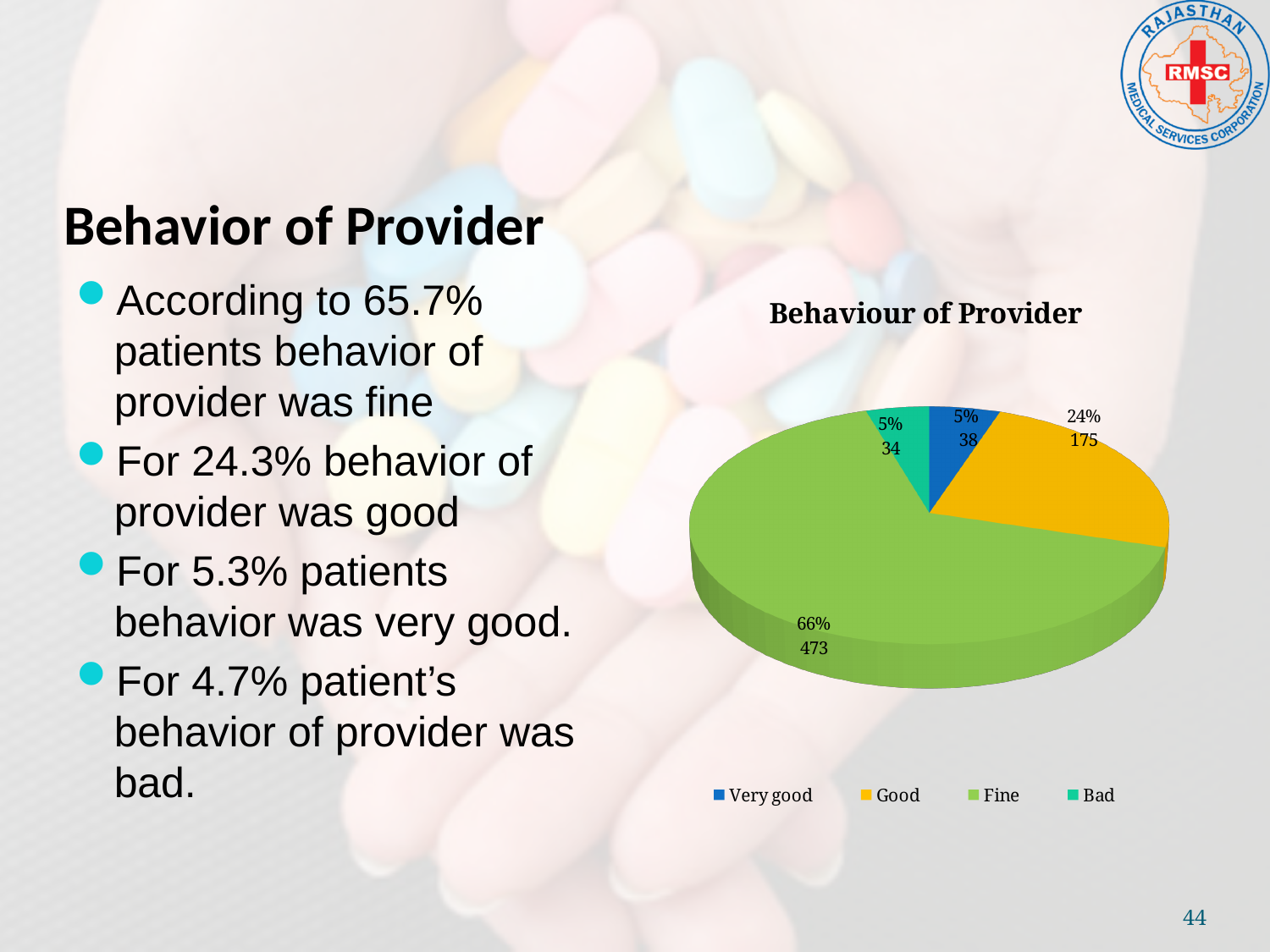
What type of chart is shown on the slide? pie chart What count is shown for the Very good slice? 38 How many categories does the legend of the pie chart list? 4 What count is shown for the Bad slice? 34 Which has a larger count, Very good or Bad? Very good What share of the pie does the Fine slice represent? 66% What is the title of the chart? Behaviour of Provider Which category has the smallest count in the pie chart? Bad What is the difference between the counts for Fine and Good? 298 Which category has the largest slice of the pie? Fine What percentage is shown for the Good slice? 24% What count is shown for the Fine slice? 473